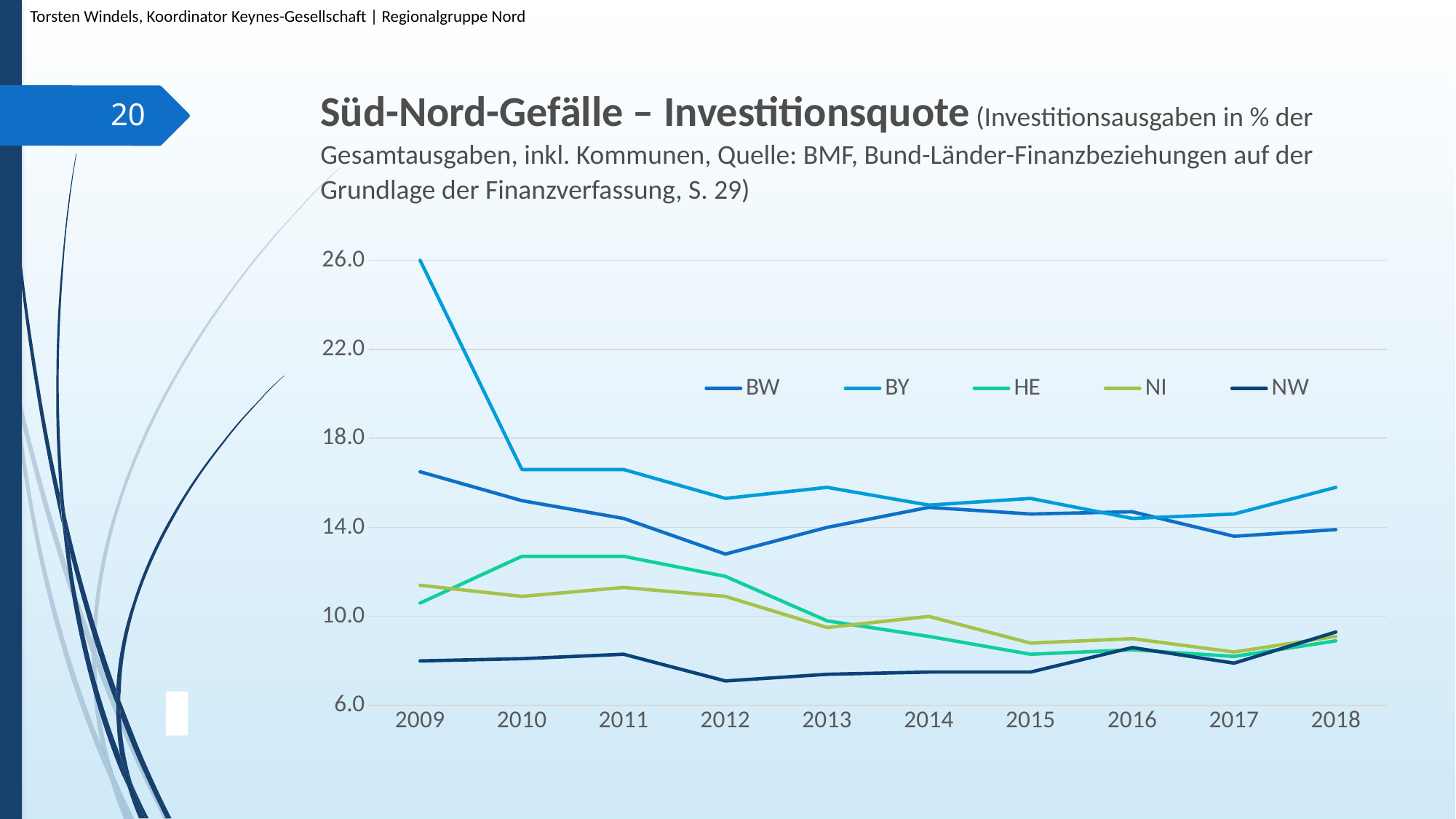
Does the BY series rise or fall from 2009 to 2012? fall Is the value for NW in 2012 greater or less than 10.0? less What kind of chart is shown on the slide? line chart Which series has the highest value in 2009? BY Is the value for BY in 2009 greater or less than 22.0? greater In 2010, which series has the larger value, HE or NI? HE Is the value for BW in 2012 greater or less than 14.0? less How many years are shown on the x axis? 10 How many series does the legend list? 5 In 2018, which series has the larger value, BY or BW? BY Which series has the lowest value in 2009? NW